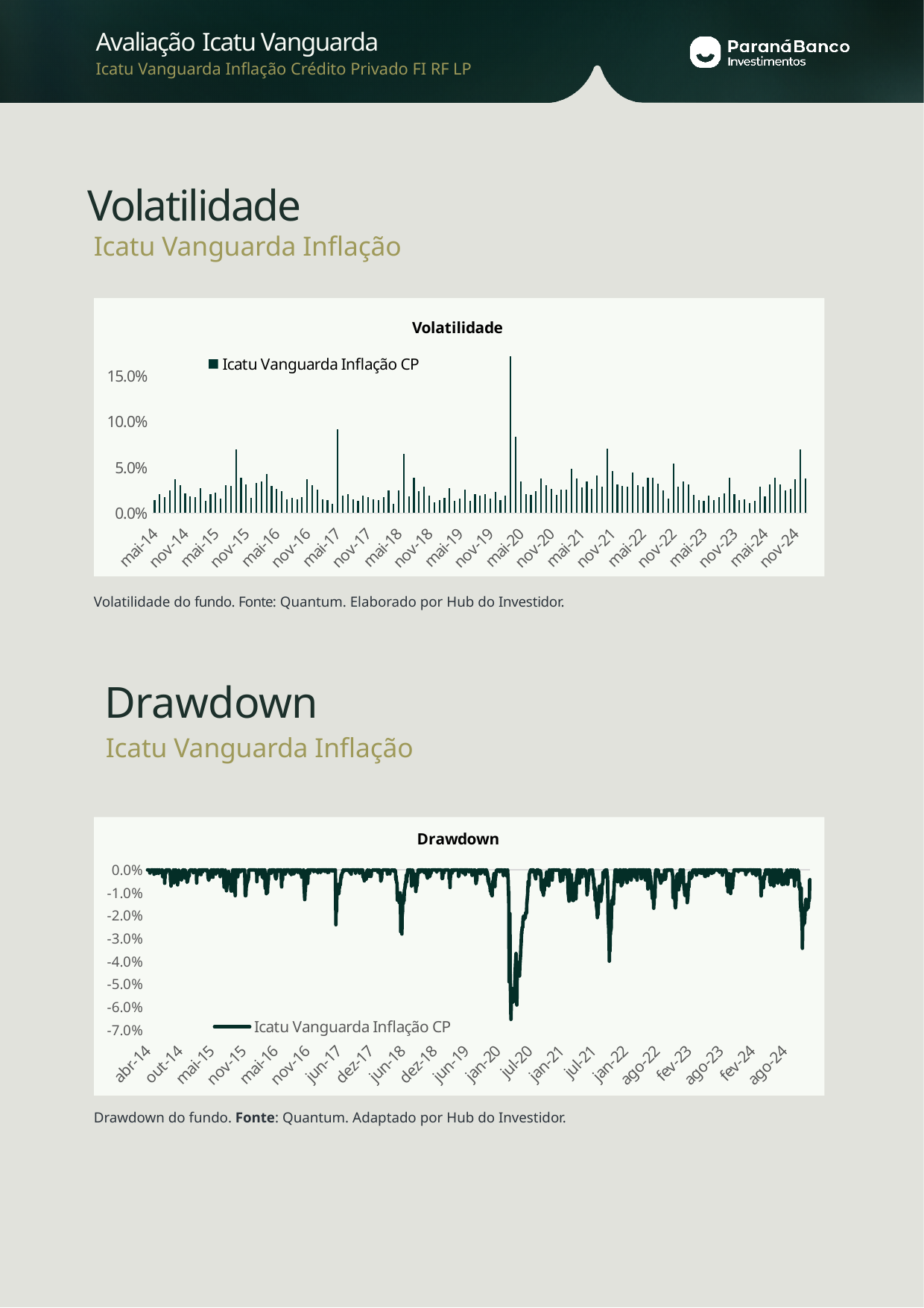
On the Drawdown chart, does the line ever fall below -7.0%? no On the Volatilidade chart, what is the last label on the x axis? nov-24 On the Volatilidade chart, is the tallest bar greater or less than 15.0%? greater What is the legend entry on the Volatilidade chart? Icatu Vanguarda Inflação CP On the Drawdown chart, is the lowest point of the line greater or less than -6.0%? less What kind of chart is the Drawdown chart? line chart On the Drawdown chart, what is the first label on the x axis? abr-14 What kind of chart is the Volatilidade chart? bar chart On the Volatilidade chart, what is the highest value shown on the y axis? 15.0% How many series does the legend of the Drawdown chart list? 1 How many series does the legend of the Volatilidade chart list? 1 On the Drawdown chart, what is the lowest value shown on the y axis? -7.0%